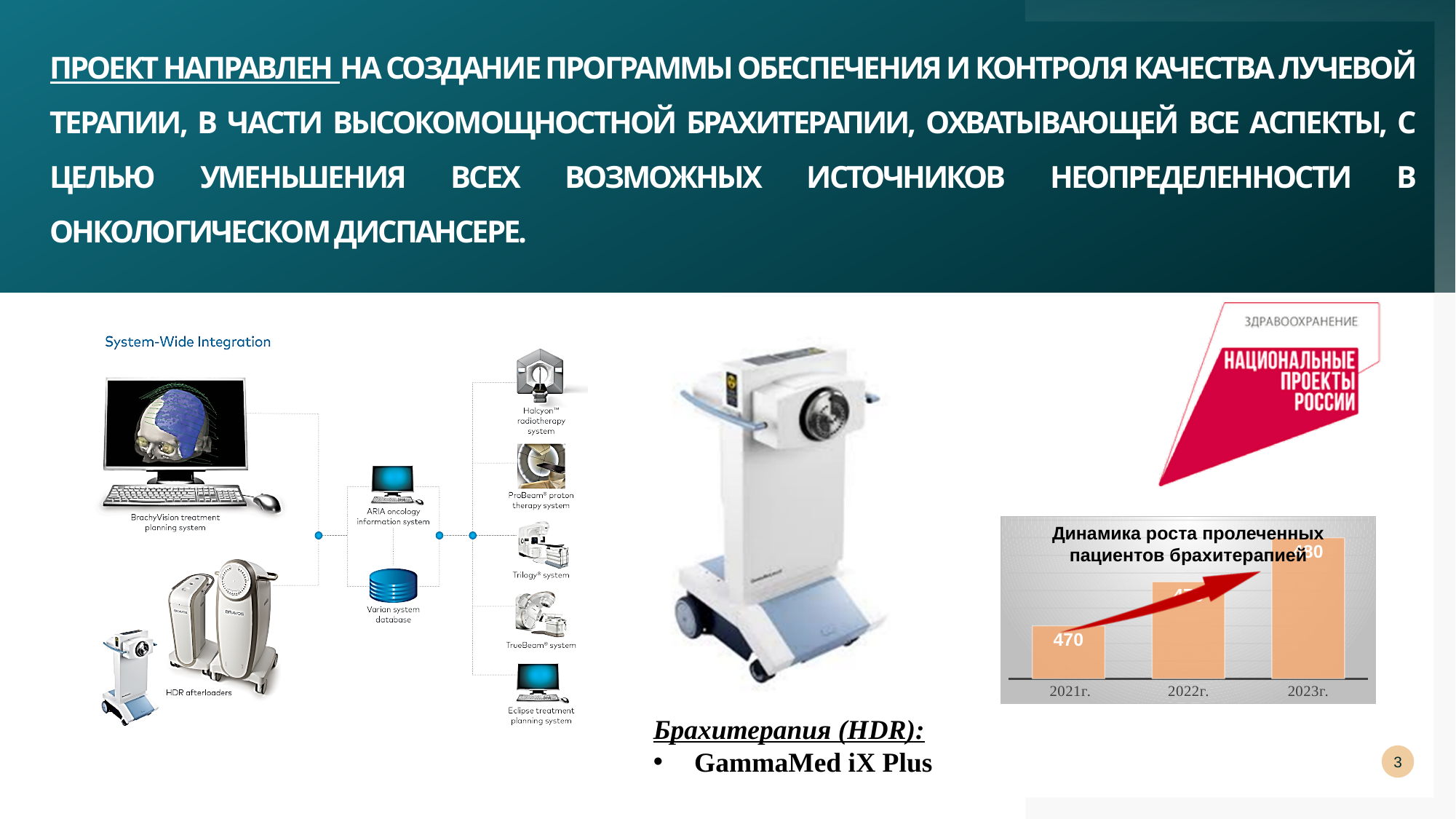
In the chart "Динамика роста пролеченных пациентов брахитерапией", which is larger, the bar for 2021г. or the bar for 2023г.? 2023г. How many years are shown on the x axis of the chart "Динамика роста пролеченных пациентов брахитерапией"? 3 What kind of chart is shown under the title "Динамика роста пролеченных пациентов брахитерапией"? bar chart In the chart "Динамика роста пролеченных пациентов брахитерапией", which year has the lowest bar? 2021г. In the chart "Динамика роста пролеченных пациентов брахитерапией", do the values rise or fall from 2021г. to 2023г.? rise In the chart "Динамика роста пролеченных пациентов брахитерапией", which is larger, the bar for 2022г. or the bar for 2023г.? 2023г. What is the first year shown on the x axis of the chart "Динамика роста пролеченных пациентов брахитерапией"? 2021г. In the chart "Динамика роста пролеченных пациентов брахитерапией", what is the value for 2021г.? 470 In the chart "Динамика роста пролеченных пациентов брахитерапией", which year has the highest bar? 2023г. What is the title of the bar chart on the right side of the slide? Динамика роста пролеченных пациентов брахитерапией